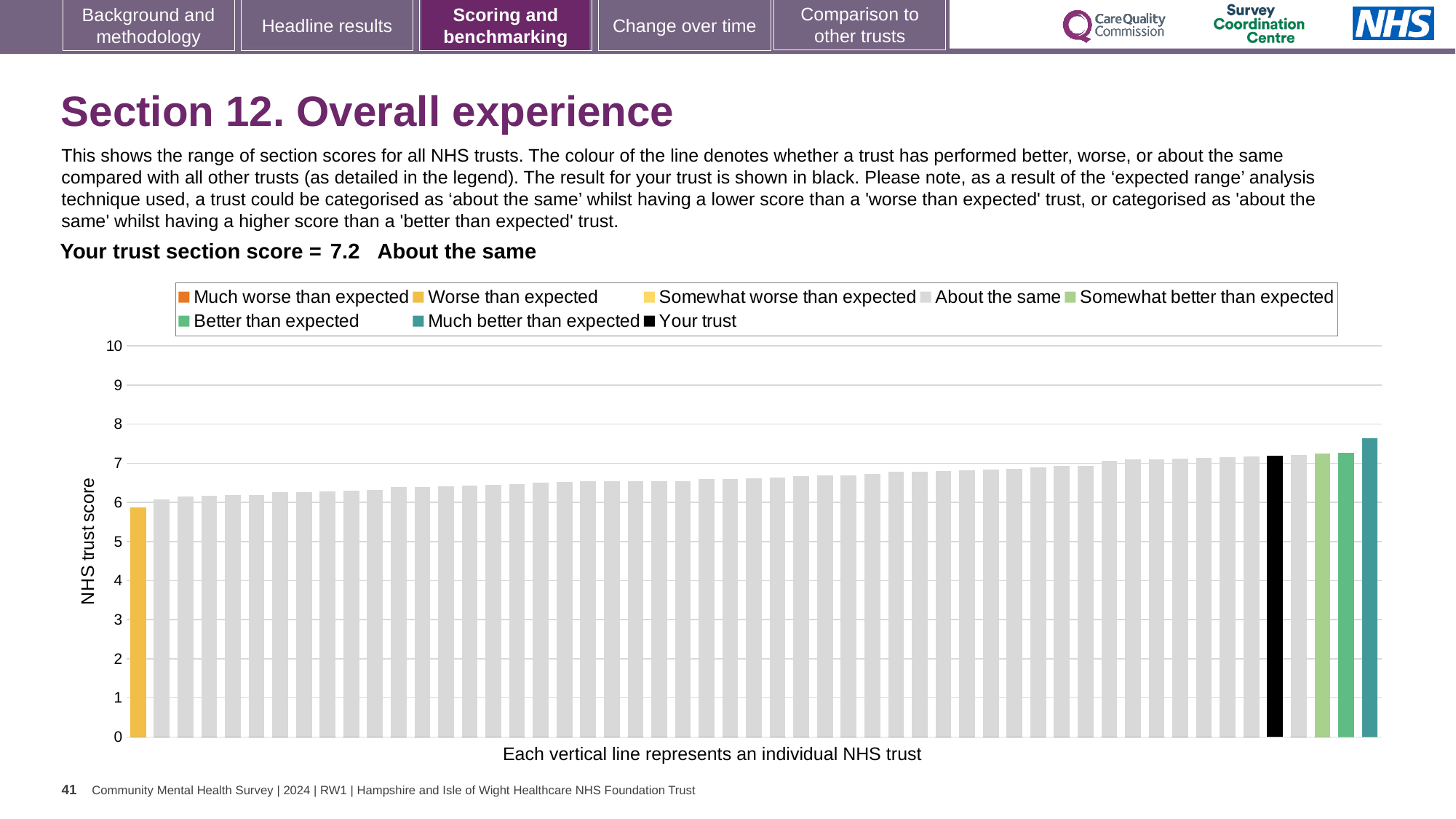
What is the label on the vertical axis of the chart? NHS trust score Is the value of the leftmost (yellow) bar greater or less than 7? less Which is larger: the value for your trust (black bar) or the value of the leftmost yellow bar? your trust How many entries does the chart legend list? 8 What is the section score for your trust shown on the slide? 7.2 What kind of chart is shown on the slide? bar chart How many bars are coloured as 'Much better than expected'? 1 Which legend category does the shortest bar belong to? Worse than expected Which legend category does the tallest bar belong to? Much better than expected Do the bar values rise or fall from left to right along the x axis? rise Is the value of the tallest bar (the rightmost, teal bar) greater or less than 8? less Is the value for your trust (the black bar) greater or less than 7? greater